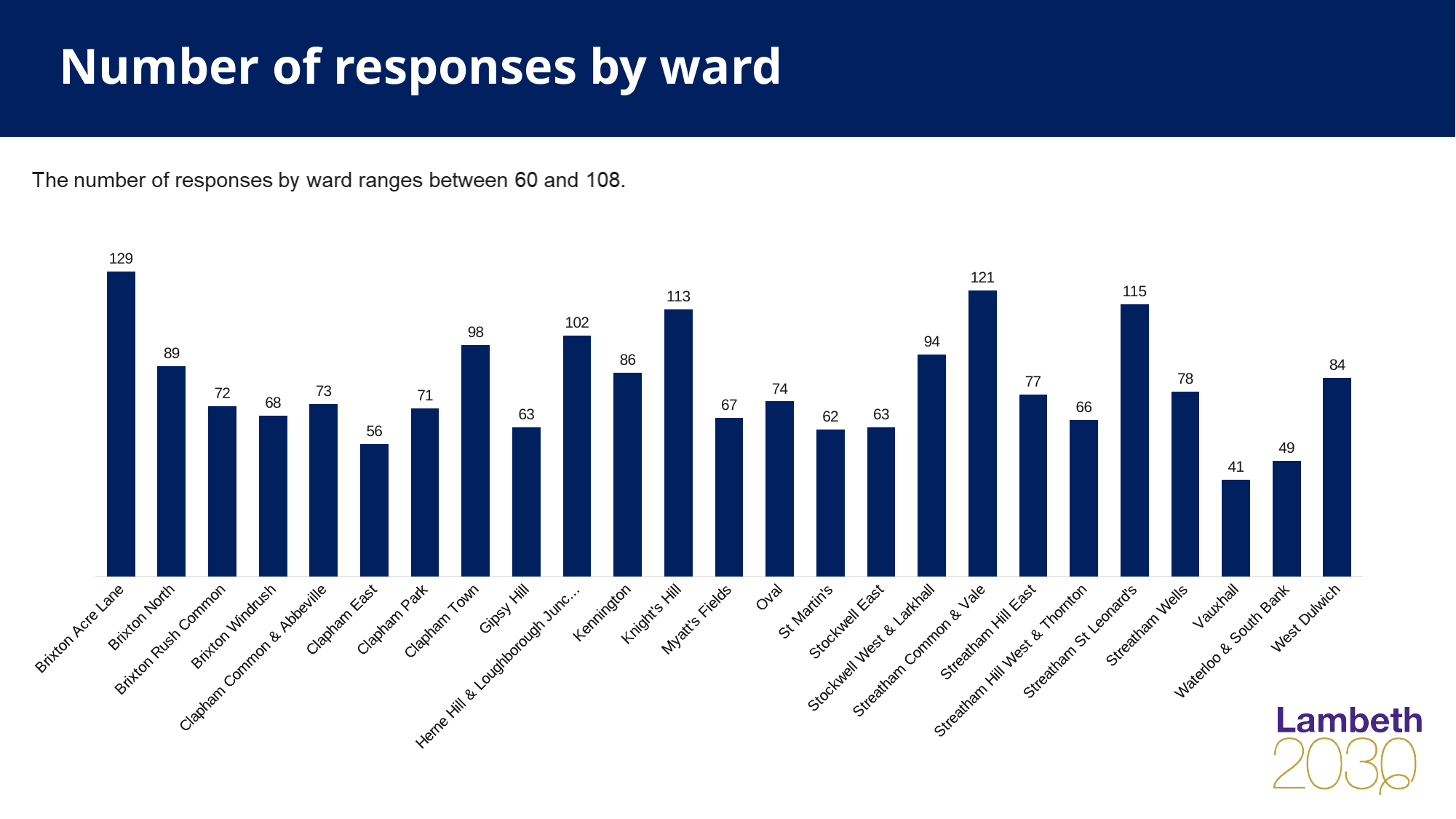
What type of chart is used on this slide? Bar chart What is the number of responses for Knight's Hill? 113 Which ward has the highest number of responses? Brixton Acre Lane What is the number of responses for Vauxhall? 41 Which has more responses, Kennington or Oval? Kennington Which ward has the lowest number of responses? Vauxhall How many responses does the chart show for Brixton Acre Lane? 129 What is the difference in responses between Clapham Town and Clapham East? 42 What is the difference in responses between Streatham St Leonard's and Streatham Wells? 37 What is the number of responses for Streatham Common & Vale? 121 Which has more responses, Waterloo & South Bank or West Dulwich? West Dulwich How many wards are shown on the chart? 25